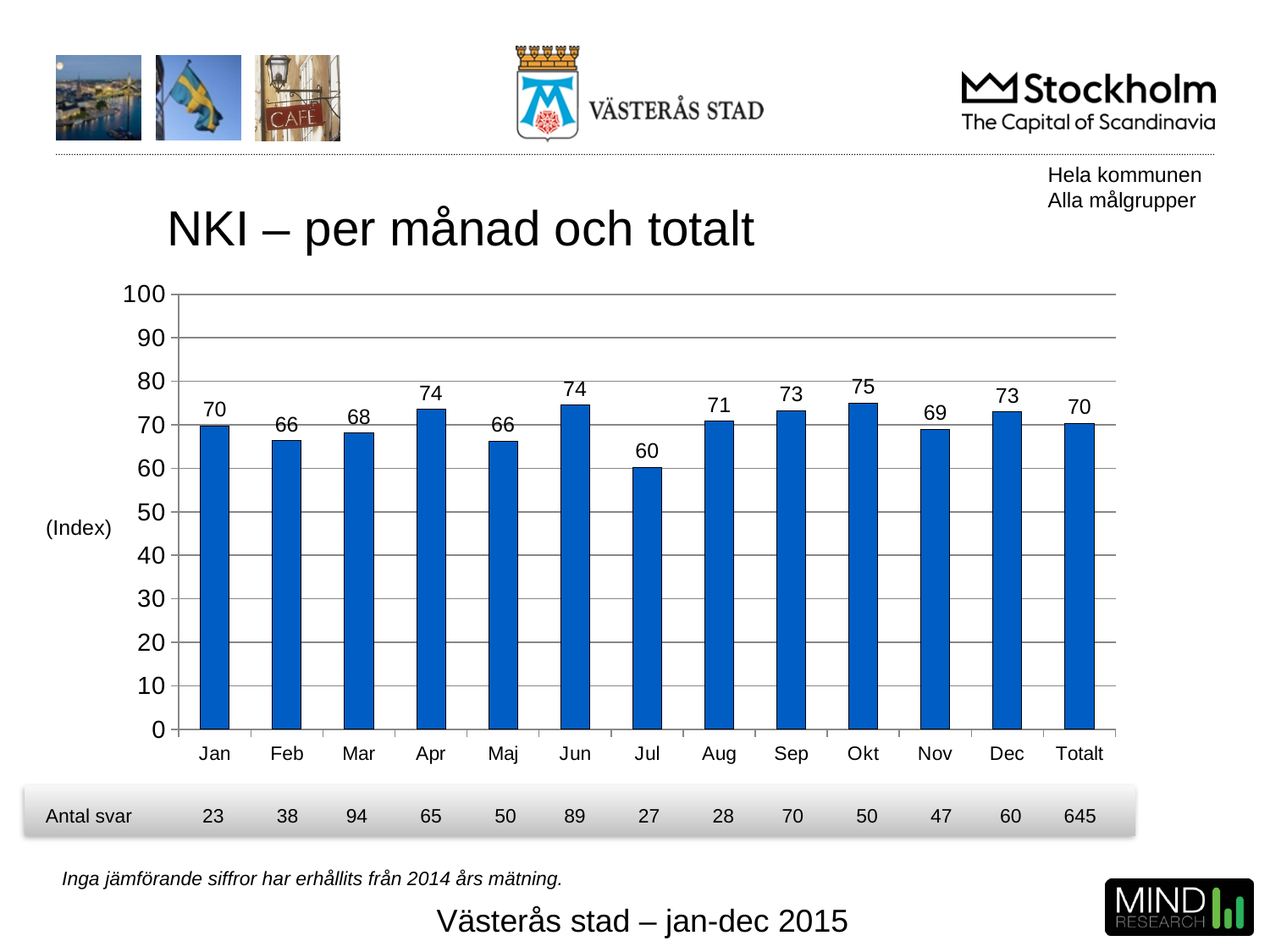
How many categories are shown on the x axis of the chart? 13 What is the title of the chart? NKI – per månad och totalt Which month has the highest NKI value? Okt Which has a higher NKI value, Apr or Mar? Apr Which month has the lowest NKI value? Jul What is the maximum value shown on the y axis of the chart? 100 What is the difference between the NKI values for Okt and Jul? 15 Is the NKI value for Jul greater or less than 70? less What is the NKI value for Okt? 75 What is the NKI value for Jul? 60 What is the NKI value for Totalt? 70 What kind of chart is shown on the slide? bar chart